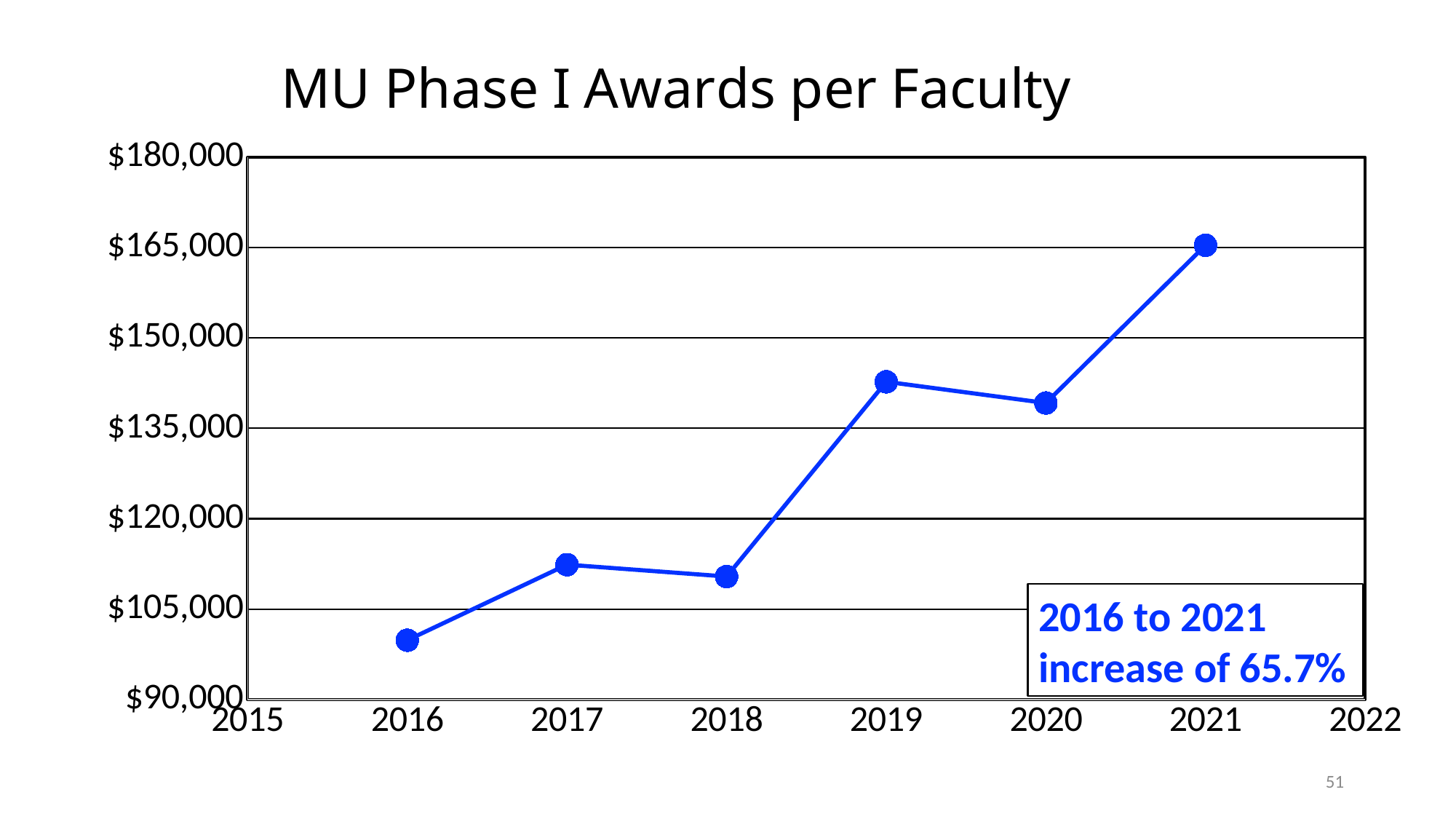
According to the annotation on the chart, what is the percentage increase from 2016 to 2021? 65.7% What kind of chart is shown on the slide? line chart Is the value for 2017 greater or less than $105,000? greater Is the value for 2021 greater or less than $150,000? greater Which is larger, the value for 2019 or the value for 2020? 2019 What is the title of the chart? MU Phase I Awards per Faculty Is the value for 2019 greater or less than $135,000? greater How many data points are plotted on the line? 6 Which year has the highest value? 2021 Which year has the lowest value? 2016